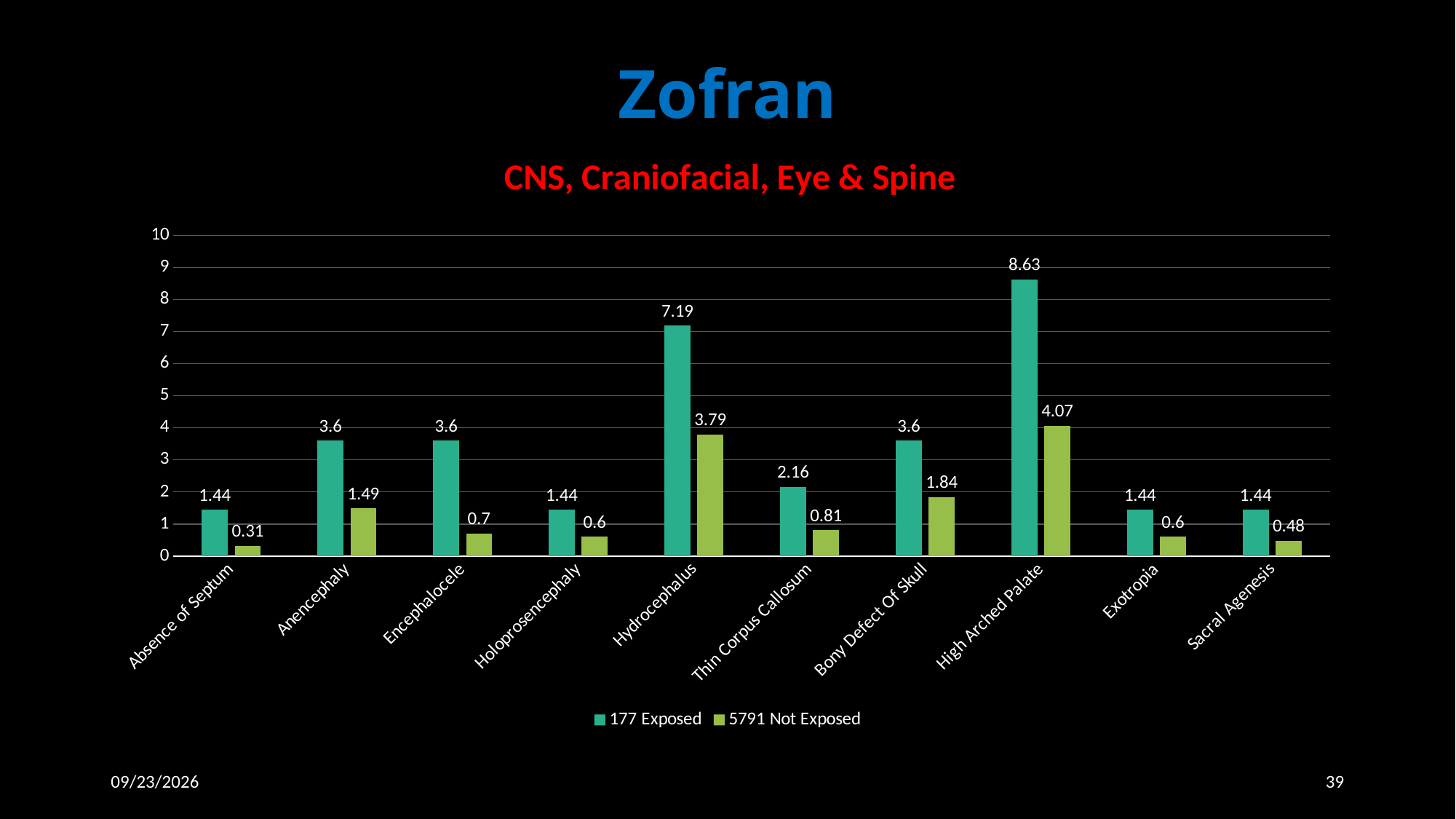
Which is larger for Anencephaly: the 177 Exposed value or the 5791 Not Exposed value? 177 Exposed How many categories are shown on the x axis? 10 What is the value for Hydrocephalus in the 177 Exposed series? 7.19 What kind of chart is shown on the slide? Bar chart What is the value for Thin Corpus Callosum in the 5791 Not Exposed series? 0.81 What is the subtitle of the chart shown in red? CNS, Craniofacial, Eye & Spine Which category has the lowest value in the 5791 Not Exposed series? Absence of Septum How many series does the legend list? 2 What is the value for High Arched Palate in the 5791 Not Exposed series? 4.07 What is the difference between the 177 Exposed and 5791 Not Exposed values for High Arched Palate? 4.56 Is the 177 Exposed value for Hydrocephalus greater or less than 5? greater Which category has the highest value in the 177 Exposed series? High Arched Palate